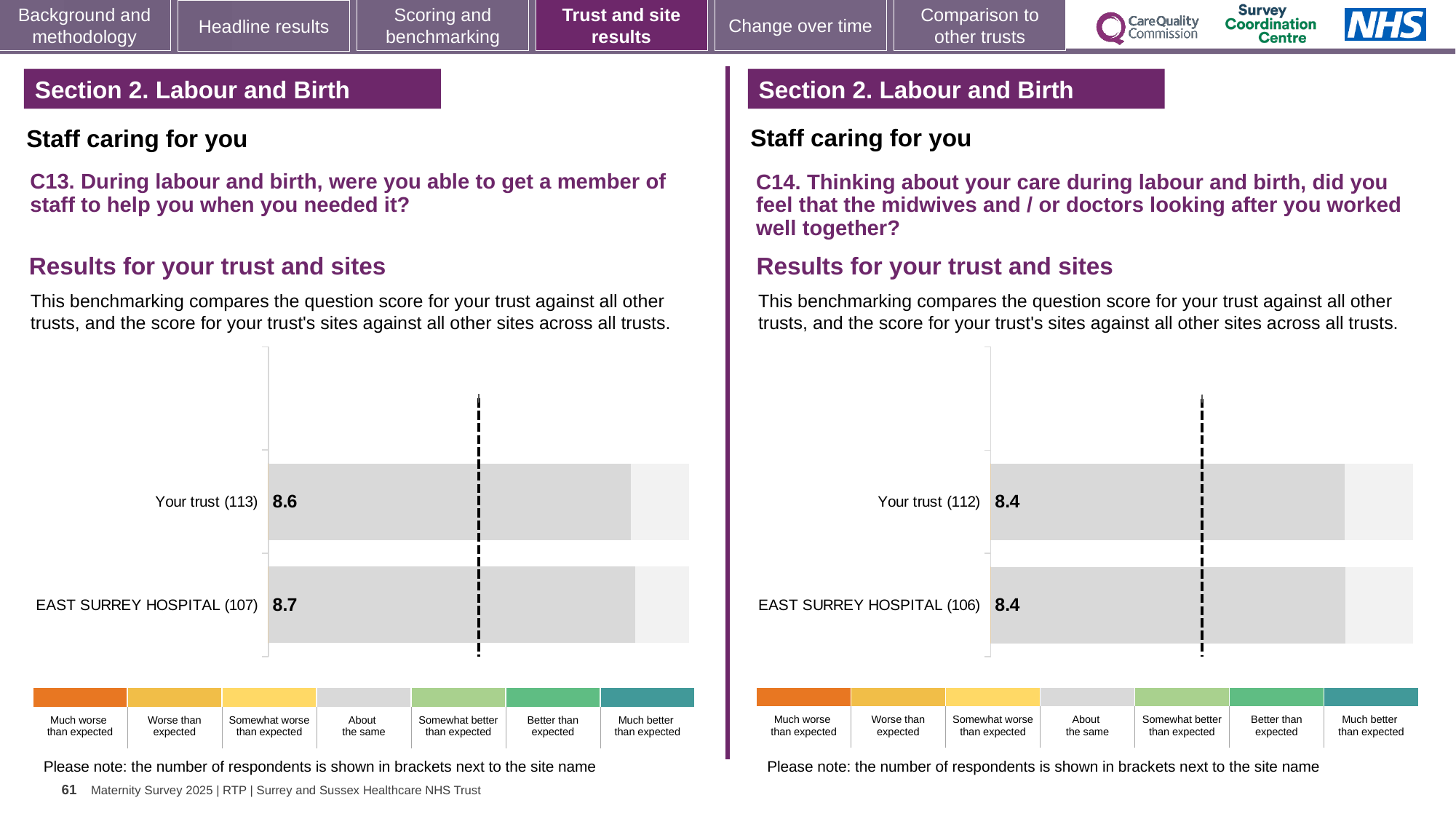
On the C13 chart (left), what is the score for EAST SURREY HOSPITAL? 8.7 On the C14 chart (right), what is the score for Your trust? 8.4 What type of chart is used on the C13 chart (left)? Bar chart On the C13 chart (left), what is the difference between the EAST SURREY HOSPITAL score and the Your trust score? 0.1 On the C14 chart (right), what is the difference between the Your trust score and the EAST SURREY HOSPITAL score? 0 On the C13 chart (left), how many respondents are shown in brackets for EAST SURREY HOSPITAL? 107 On the C14 chart (right), what is the score for EAST SURREY HOSPITAL? 8.4 How many bars are plotted on the C14 chart (right)? 2 On the C14 chart (right), how many respondents are shown in brackets for Your trust? 112 How many bars are plotted on the C13 chart (left)? 2 On the C13 chart (left), what is the score for Your trust? 8.6 On the C13 chart (left), which has the higher score, Your trust or EAST SURREY HOSPITAL? EAST SURREY HOSPITAL